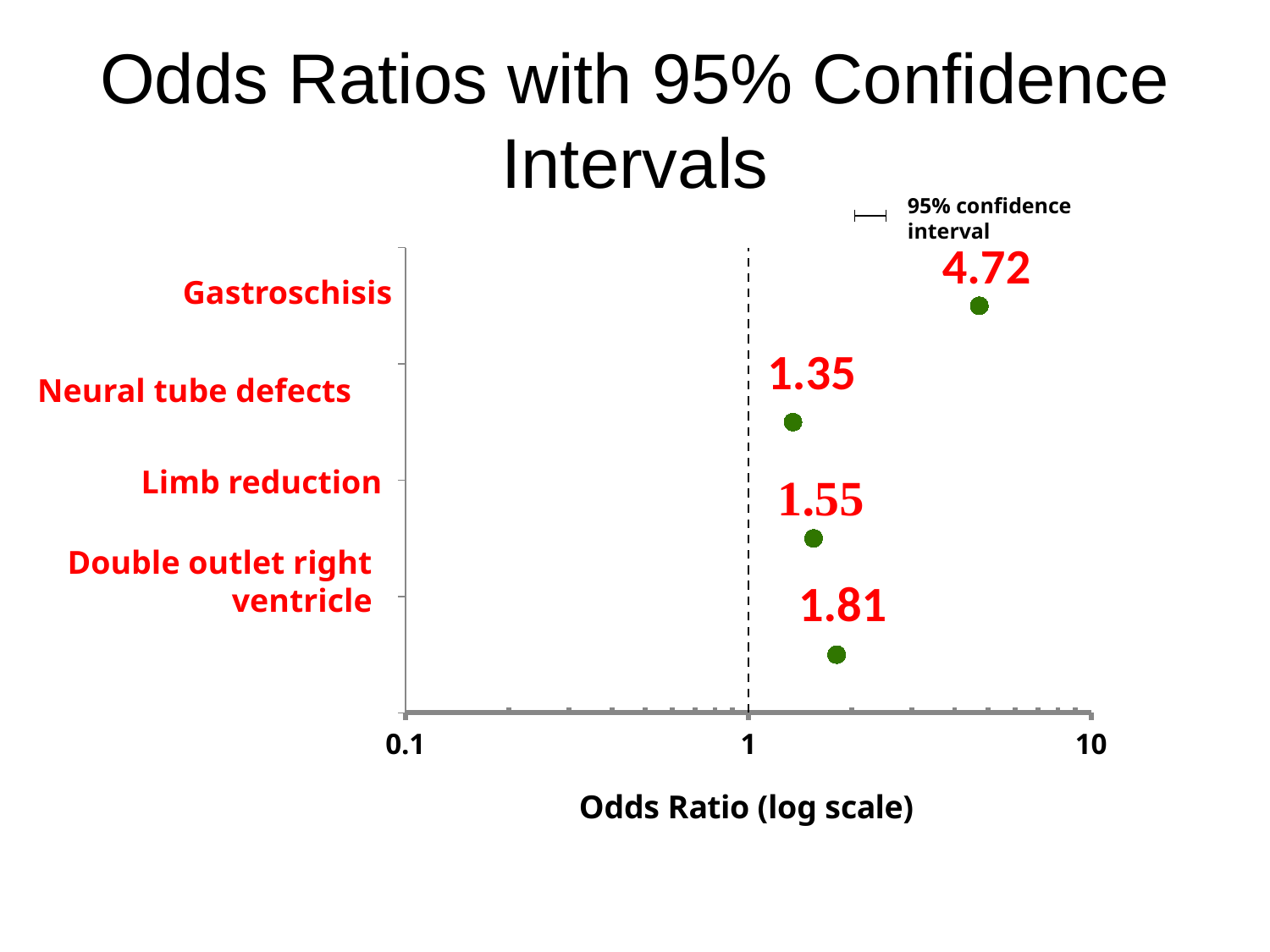
What is the odds ratio shown for Double outlet right ventricle? 1.81 What is the odds ratio shown for Limb reduction? 1.55 Which category has the lowest odds ratio? Neural tube defects What is the odds ratio shown for Gastroschisis? 4.72 What is the label of the horizontal axis? Odds Ratio (log scale) How many categories are plotted on the chart? 4 What is the difference between the odds ratios for Gastroschisis and Double outlet right ventricle? 2.91 What is the title of the chart? Odds Ratios with 95% Confidence Intervals Which has a larger odds ratio, Limb reduction or Double outlet right ventricle? Double outlet right ventricle Which category has the highest odds ratio? Gastroschisis What is the odds ratio shown for Neural tube defects? 1.35 Is the odds ratio for Gastroschisis greater or less than 1? greater